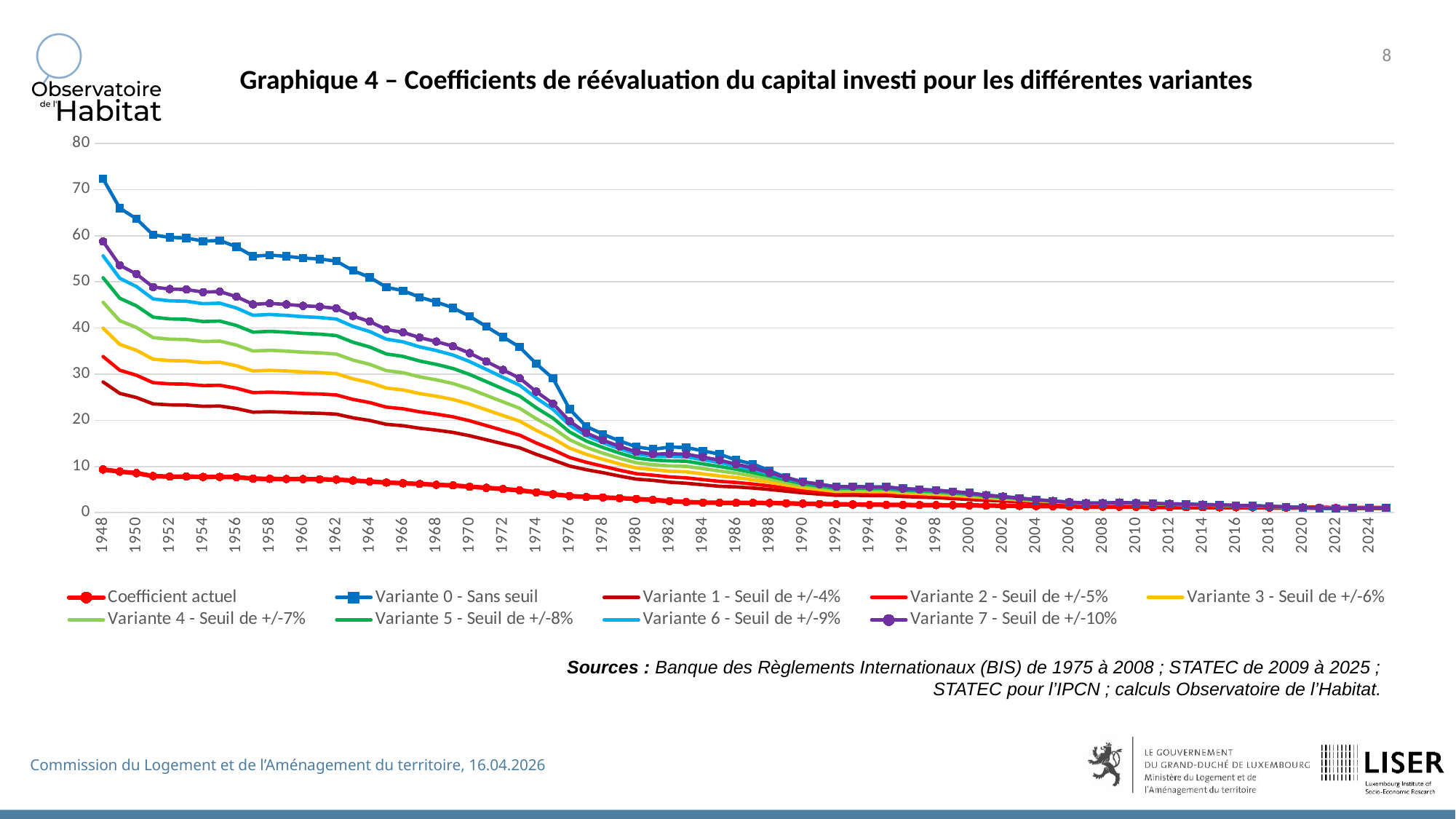
What kind of chart is shown on the slide? line chart Is the value for Variante 1 - Seuil de +/-4% in 1948 greater or less than 30? less What is the title of the chart? Graphique 4 – Coefficients de réévaluation du capital investi pour les différentes variantes Is the value for Variante 7 - Seuil de +/-10% in 1948 greater or less than 50? greater Is the value for Variante 0 - Sans seuil in 1948 greater or less than 70? greater Do the values of Variante 0 - Sans seuil rise or fall from 1948 to 2024? fall Which series has the lowest value in 1948? Coefficient actuel Which series has the highest value in 1948? Variante 0 - Sans seuil How many series does the legend list? 9 In 1960, which is larger: Variante 0 - Sans seuil or Variante 7 - Seuil de +/-10%? Variante 0 - Sans seuil What threshold is given in the legend for Variante 3? +/-6%